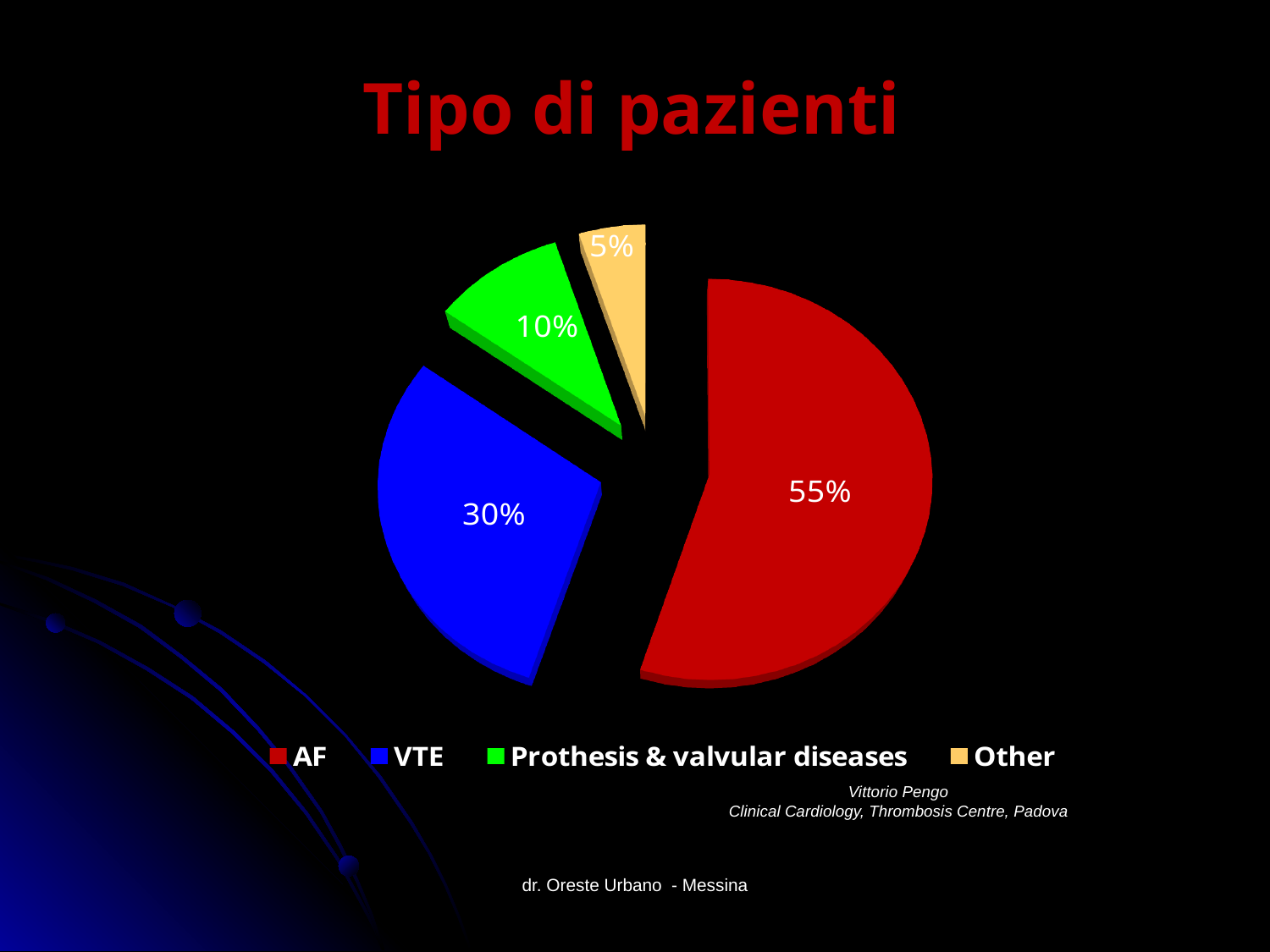
What share of patients is Other? 5% How many categories does the pie chart have? 4 Which category has the smallest slice of the pie? Other What kind of chart is shown on the slide? pie chart What is the difference in percentage points between AF and VTE? 25 Which is larger, VTE or Prothesis & valvular diseases? VTE What share of patients is VTE? 30% What is the title of the slide? Tipo di pazienti What colour is the VTE slice? blue What share of patients is Prothesis & valvular diseases? 10% Which category has the largest slice of the pie? AF What share of patients is AF? 55%